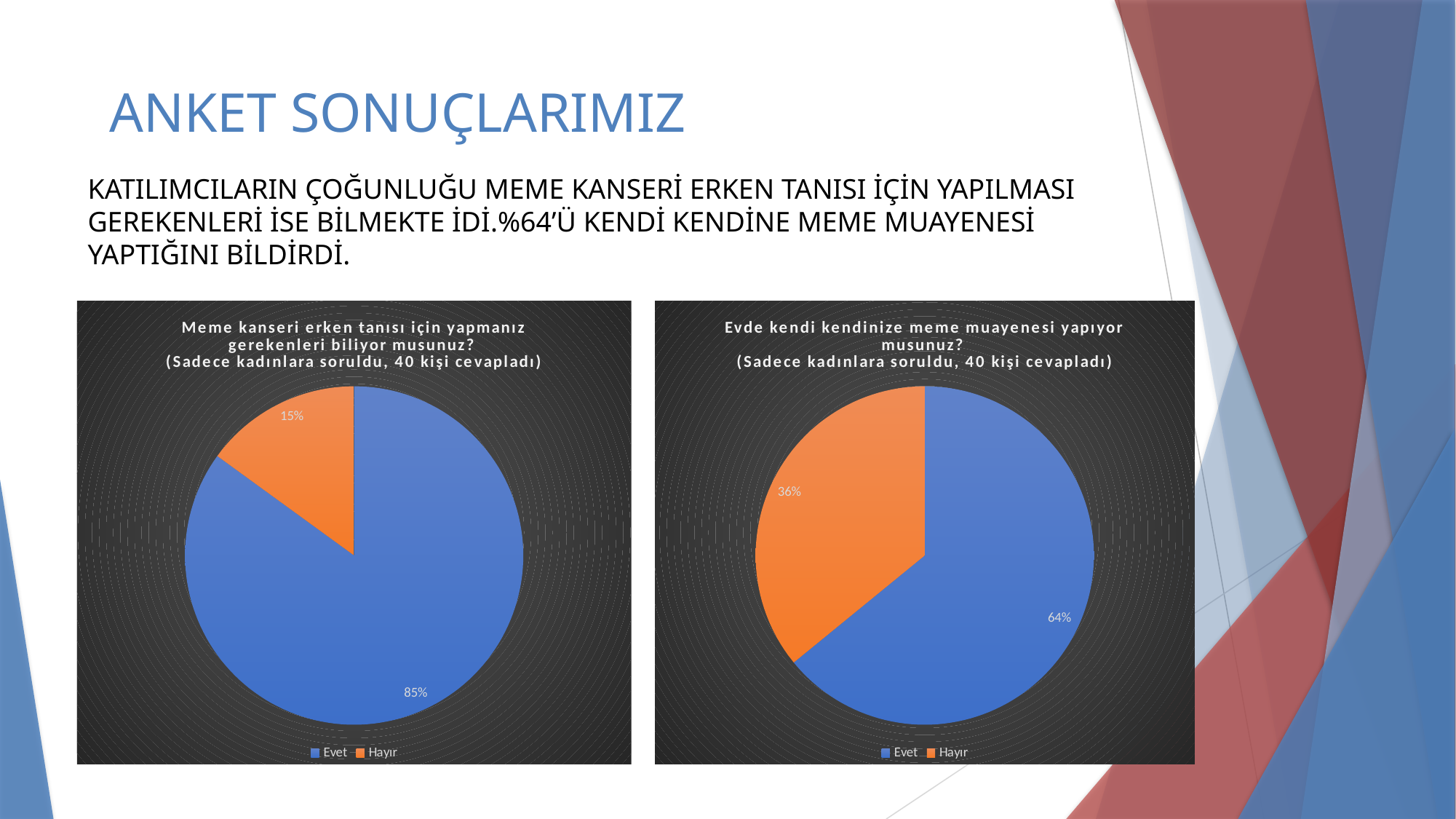
In the left chart (Meme kanseri erken tanısı için yapmanız gerekenleri biliyor musunuz?), what share of respondents answered Evet? 85% How many categories does the legend of the left chart list? 2 In the right chart (Evde kendi kendinize meme muayenesi yapıyor musunuz?), what share of respondents answered Evet? 64% Which chart has the larger Evet share, the left chart or the right chart? The left chart In the left chart (Meme kanseri erken tanısı için yapmanız gerekenleri biliyor musunuz?), what share of respondents answered Hayır? 15% In the left chart, what is the difference between the Evet and Hayır shares? 70% In the right chart, which colour represents Hayır? Orange In the right chart (Evde kendi kendinize meme muayenesi yapıyor musunuz?), what share of respondents answered Hayır? 36% What type of chart is the right chart? Pie chart In the left chart, which answer has the largest slice? Evet In the right chart, which answer has the smallest slice? Hayır In the right chart, what is the difference between the Evet and Hayır shares? 28%